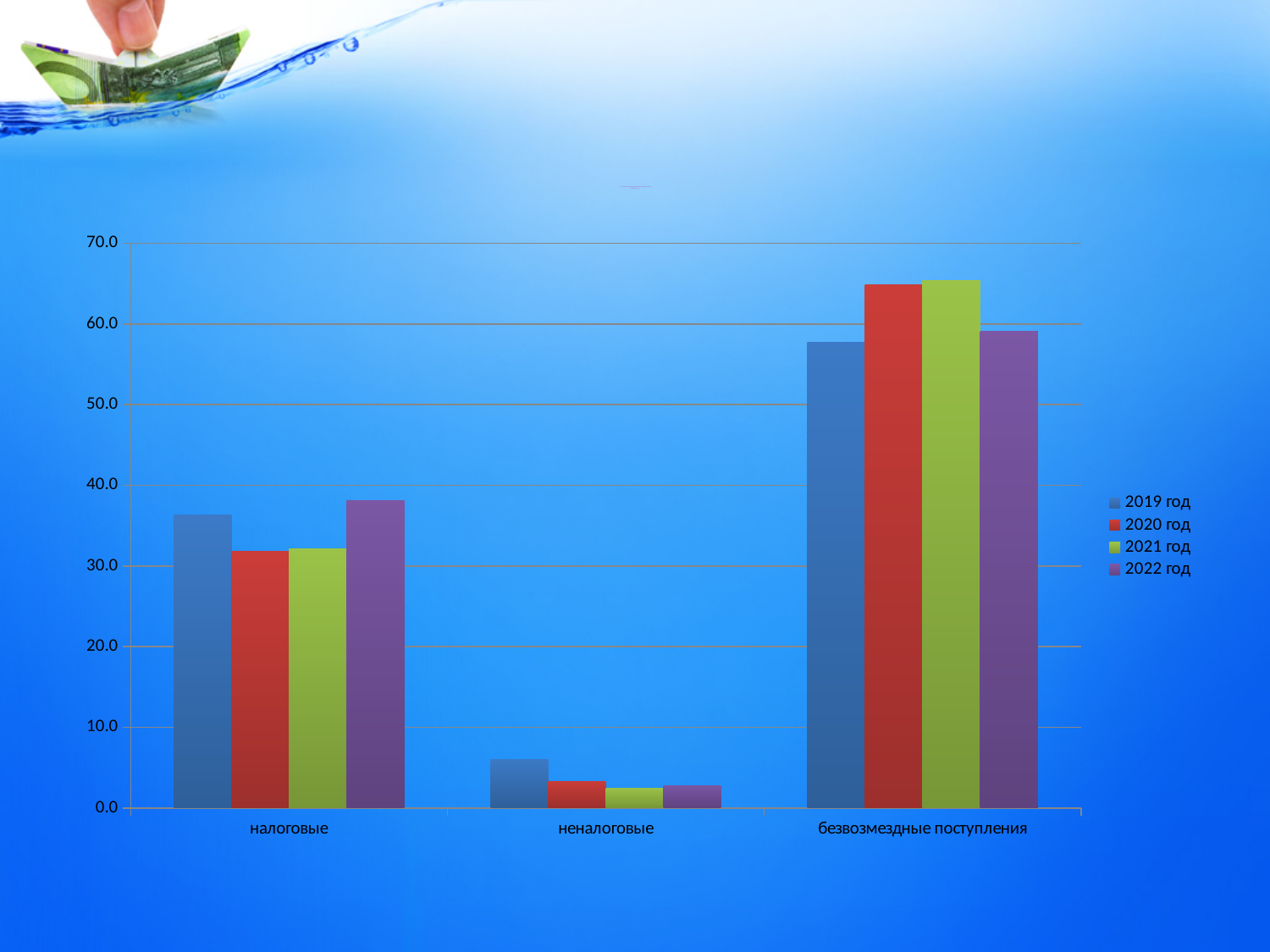
How many categories are shown on the x axis of the chart? 3 Which colour represents the 2022 год series in the legend? purple Is the value for 2020 год in the безвозмездные поступления category greater or less than 60.0? greater How many series does the legend list? 4 Which category has the highest bars in the chart? безвозмездные поступления Which category has the lowest bars in the chart? неналоговые Is the value for 2019 год in the неналоговые category greater or less than 10.0? less Is the value for 2022 год in the налоговые category greater or less than 40.0? less In the безвозмездные поступления category, which is larger: the value for 2019 год or the value for 2021 год? 2021 год What kind of chart is shown on the slide? bar chart In the налоговые category, which is larger: the value for 2022 год or the value for 2020 год? 2022 год